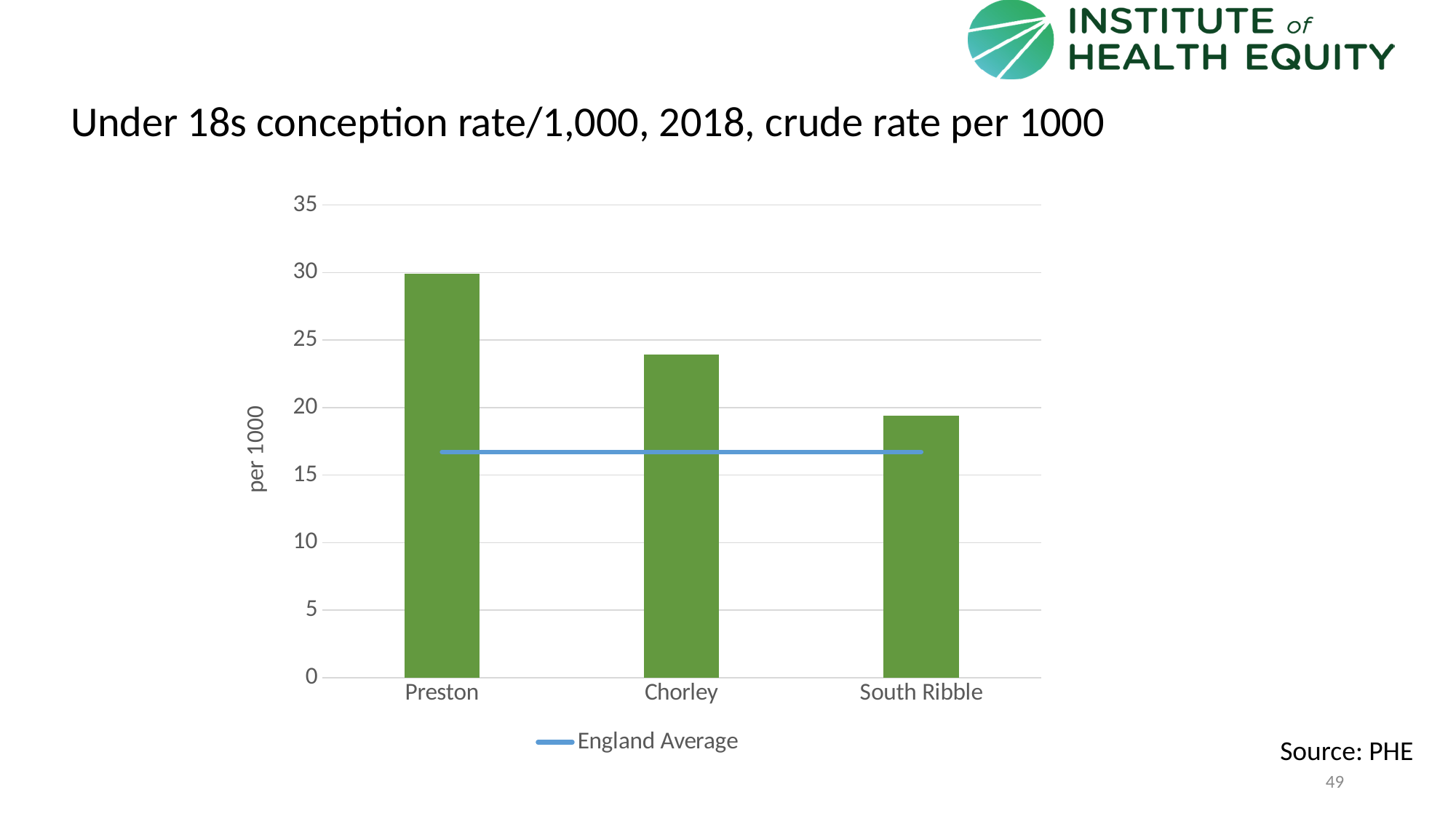
How many areas are shown as bars on the chart? 3 Is the England Average line greater or less than 20? less What kind of chart is shown on the slide? bar chart Which is larger, the value for Chorley or the value for South Ribble? Chorley Which area has the highest under 18s conception rate? Preston Is the value for Chorley greater or less than 25? less Which area has the lowest under 18s conception rate? South Ribble How many entries does the legend list? 1 Is the value for Preston greater or less than 25? greater Do the bar values rise or fall from Preston to South Ribble along the x axis? fall What is the label on the vertical axis? per 1000